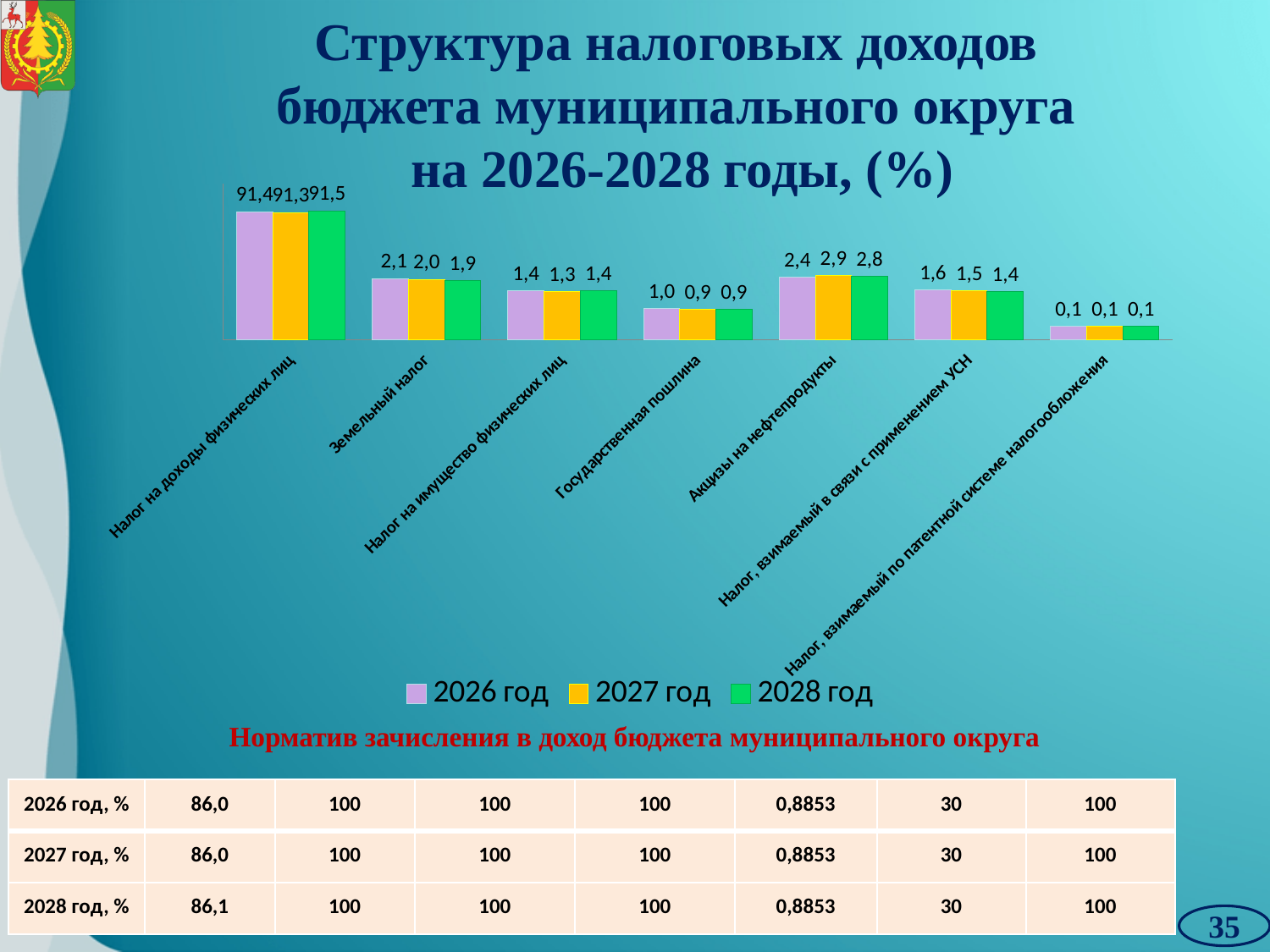
What kind of chart is shown on the slide? bar chart What is the difference between the 2026 год and 2028 год values for Налог, взимаемый в связи с применением УСН? 0,2 What is the 2026 год value for Земельный налог? 2,1 How many categories are shown on the x axis of the chart? 7 Which category has the lowest value for 2028 год? Налог, взимаемый по патентной системе налогообложения What is the 2028 год value for Налог на доходы физических лиц? 91,5 What is the 2027 год value for Акцизы на нефтепродукты? 2,9 Which colour represents 2027 год in the chart? yellow Which is larger for 2027 год: Акцизы на нефтепродукты or Земельный налог? Акцизы на нефтепродукты How many series does the legend list? 3 Which category has the highest value for 2026 год? Налог на доходы физических лиц What is the 2027 год value for Государственная пошлина? 0,9